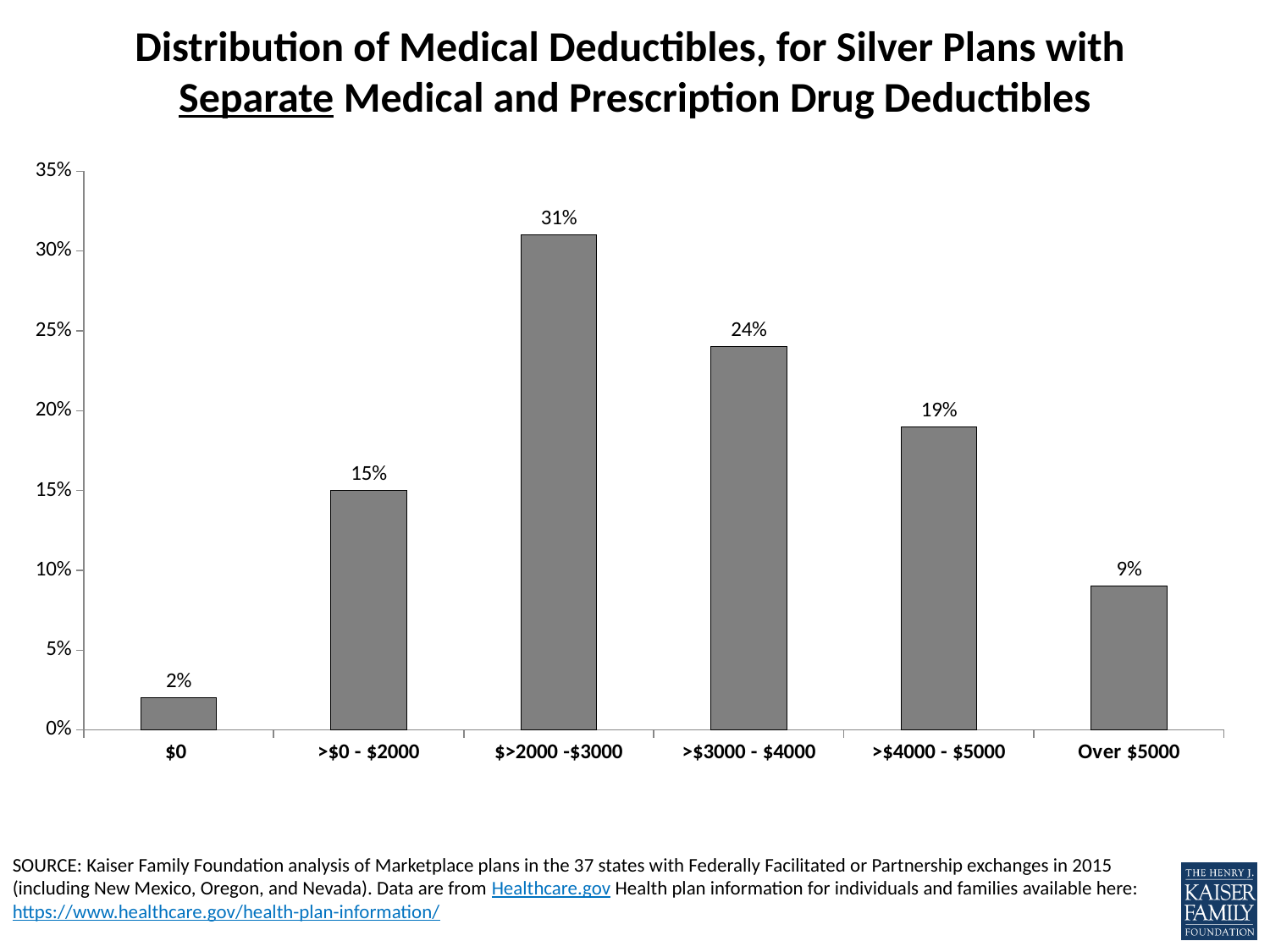
What percentage of silver plans have a medical deductible of $0? 2% Which deductible category has the lowest percentage of plans? $0 Is the value for ">$3000 - $4000" greater or less than 20%? greater What is the difference in percentage points between the ">$2000 - $3000" and ">$3000 - $4000" categories? 7 percentage points Which deductible category has the highest percentage of plans? >$2000 - $3000 How many deductible categories are shown on the x axis? 6 What type of chart is shown on the slide? Bar chart What share of plans have a medical deductible over $5000? 9% Which is larger: the value for ">$0 - $2000" or the value for ">$4000 - $5000"? >$4000 - $5000 What is the value for the ">$2000 - $3000" deductible category? 31% What is the title of the chart? Distribution of Medical Deductibles, for Silver Plans with Separate Medical and Prescription Drug Deductibles What is the value for the ">$4000 - $5000" category? 19%